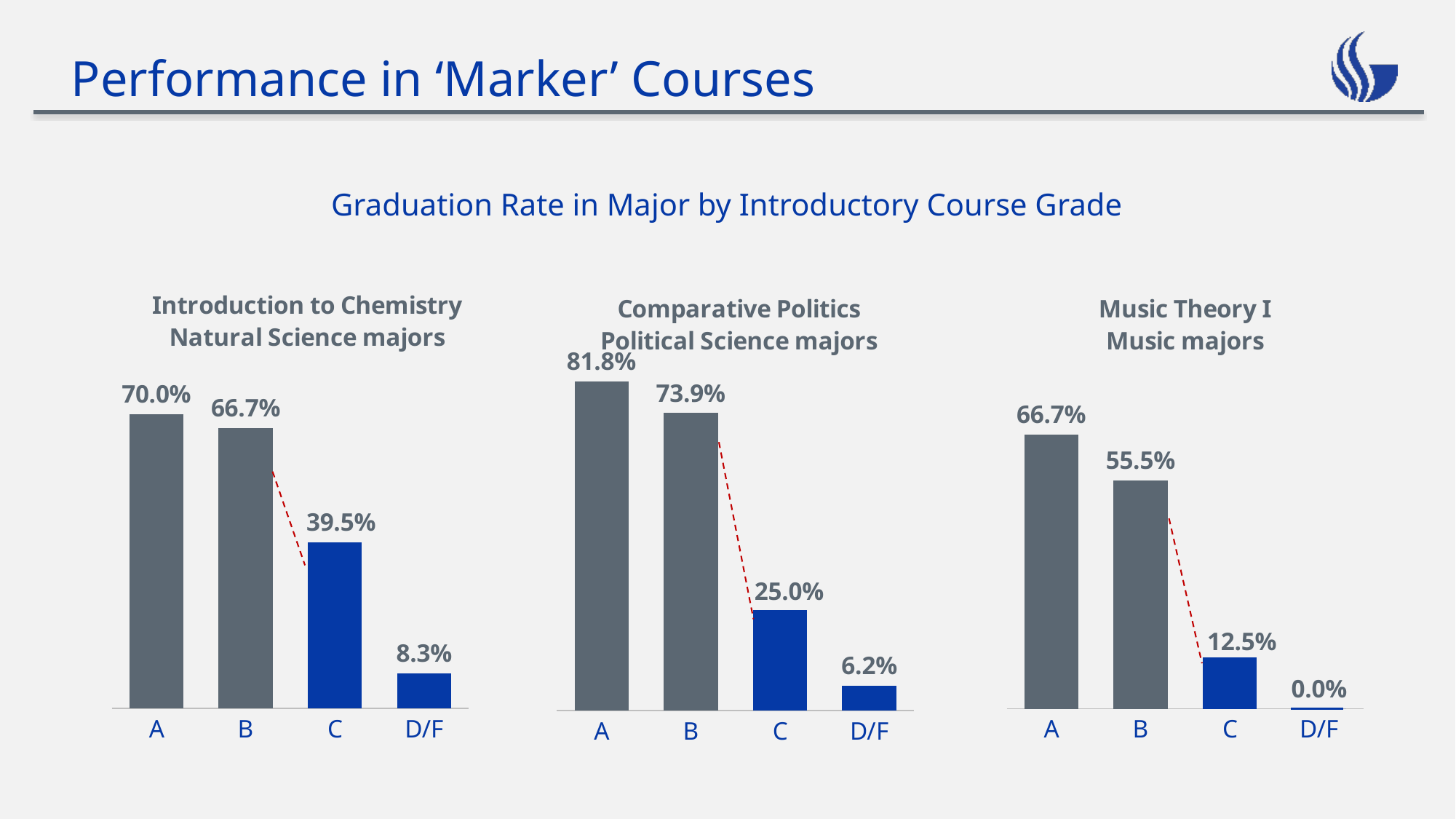
In the Introduction to Chemistry chart, what is the difference between the graduation rates for grades B and C? 27.2% How many grade categories are shown in the Music Theory I chart? 4 What kind of chart is the Comparative Politics chart? Bar chart In the Introduction to Chemistry chart, what is the graduation rate for students who earned a B? 66.7% In the Comparative Politics chart, what is the graduation rate for students who earned an A? 81.8% In the Introduction to Chemistry chart, do the graduation rates rise or fall from grade A to grade D/F? Fall In the Comparative Politics chart, which grade has the lowest graduation rate? D/F In the Music Theory I chart, what is the graduation rate for students who earned a D/F? 0.0% In the Comparative Politics chart, what is the difference between the graduation rates for grades A and B? 7.9% Which is larger: the graduation rate for grade C in the Introduction to Chemistry chart or the graduation rate for grade C in the Comparative Politics chart? Introduction to Chemistry How many charts are shown on the slide? 3 In the Music Theory I chart, which grade has the highest graduation rate? A